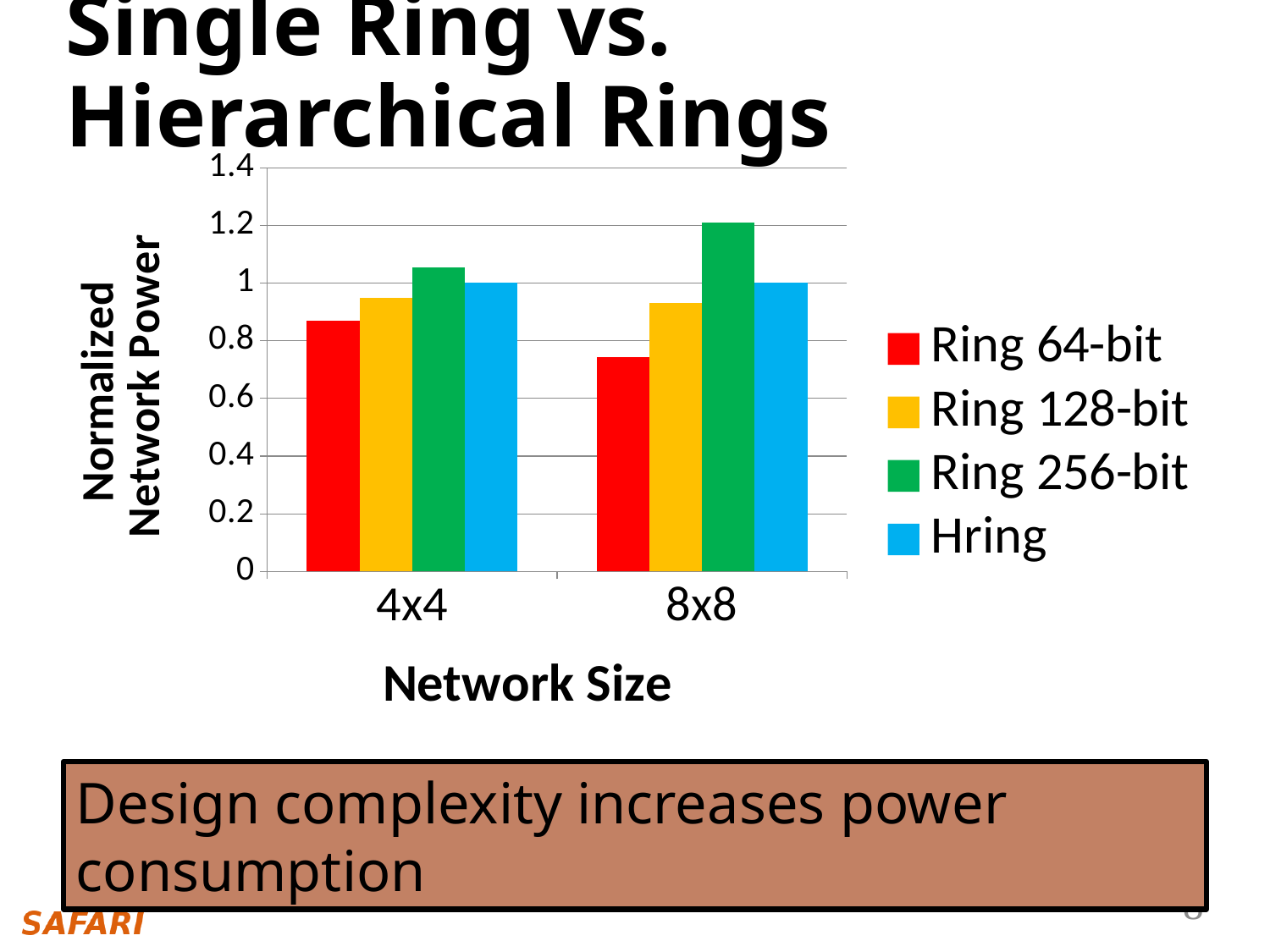
Is the value for Ring 256-bit at 8x8 greater or less than 1? greater For Ring 64-bit, which network size has the larger value, 4x4 or 8x8? 4x4 How many network sizes are shown on the x axis? 2 Which series has the lowest value at network size 8x8? Ring 64-bit What is the value for Hring at network size 8x8? 1 What is the title of the y axis? Normalized Network Power Which series has the highest value at network size 8x8? Ring 256-bit Is the value for Ring 64-bit at 8x8 greater or less than 0.8? less Which series has the lowest value at network size 4x4? Ring 64-bit Is the value for Ring 128-bit at 4x4 greater or less than 1? less What kind of chart is shown on the slide? bar chart How many series does the legend list? 4